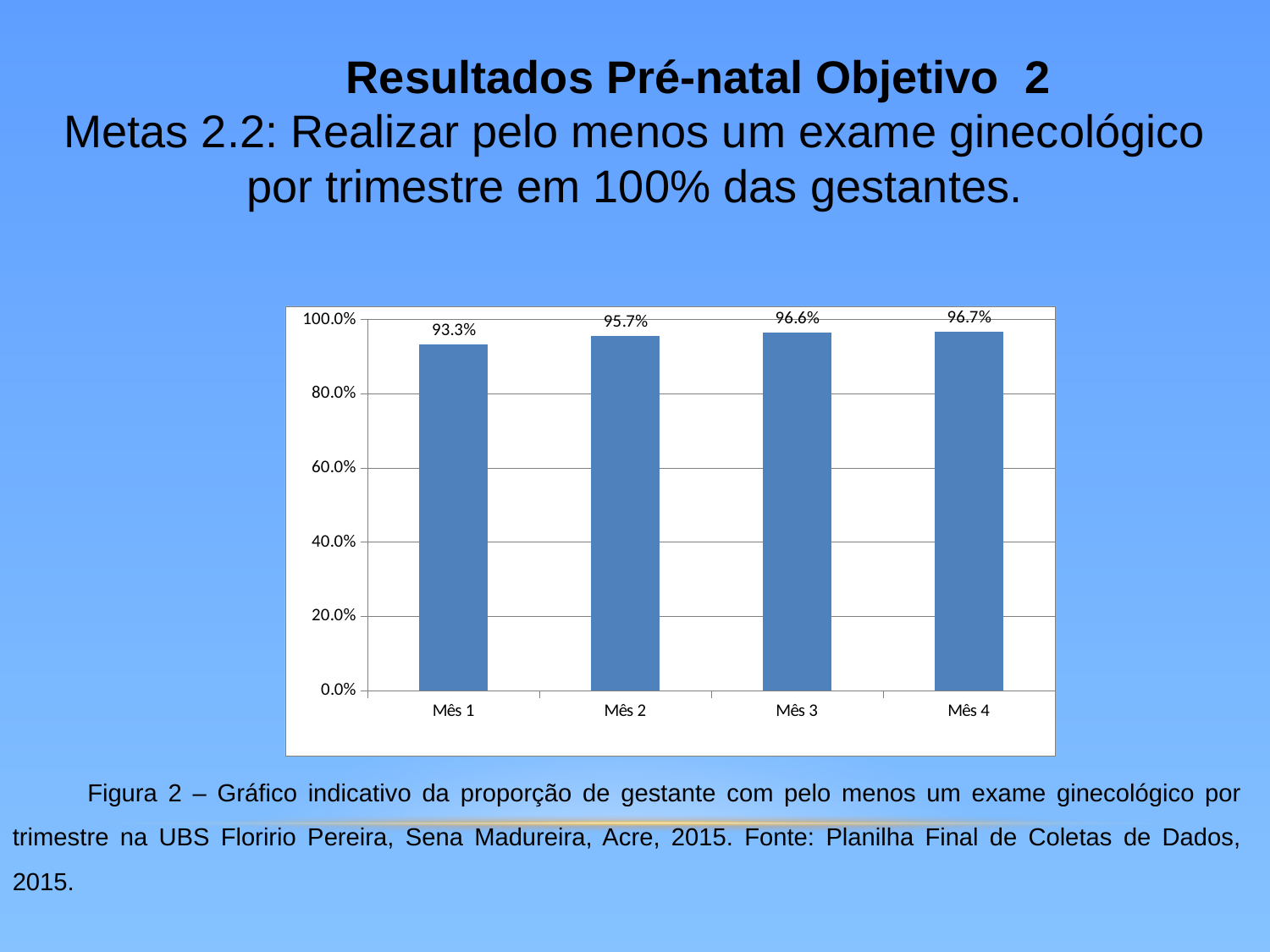
Which month has the lowest value? Mês 1 What kind of chart is shown on the slide? Bar chart What is the value for Mês 1? 93.3% Which month has the highest value? Mês 4 What is the value for Mês 2? 95.7% How many months (categories) are shown on the x axis? 4 What is the difference between the values for Mês 4 and Mês 1? 3.4 percentage points Do the values rise or fall from Mês 1 to Mês 4? Rise Which is larger, the value for Mês 2 or the value for Mês 1? Mês 2 What is the value for Mês 3? 96.6% What is the value for Mês 4? 96.7% Is the value for Mês 3 greater or less than 80.0%? greater